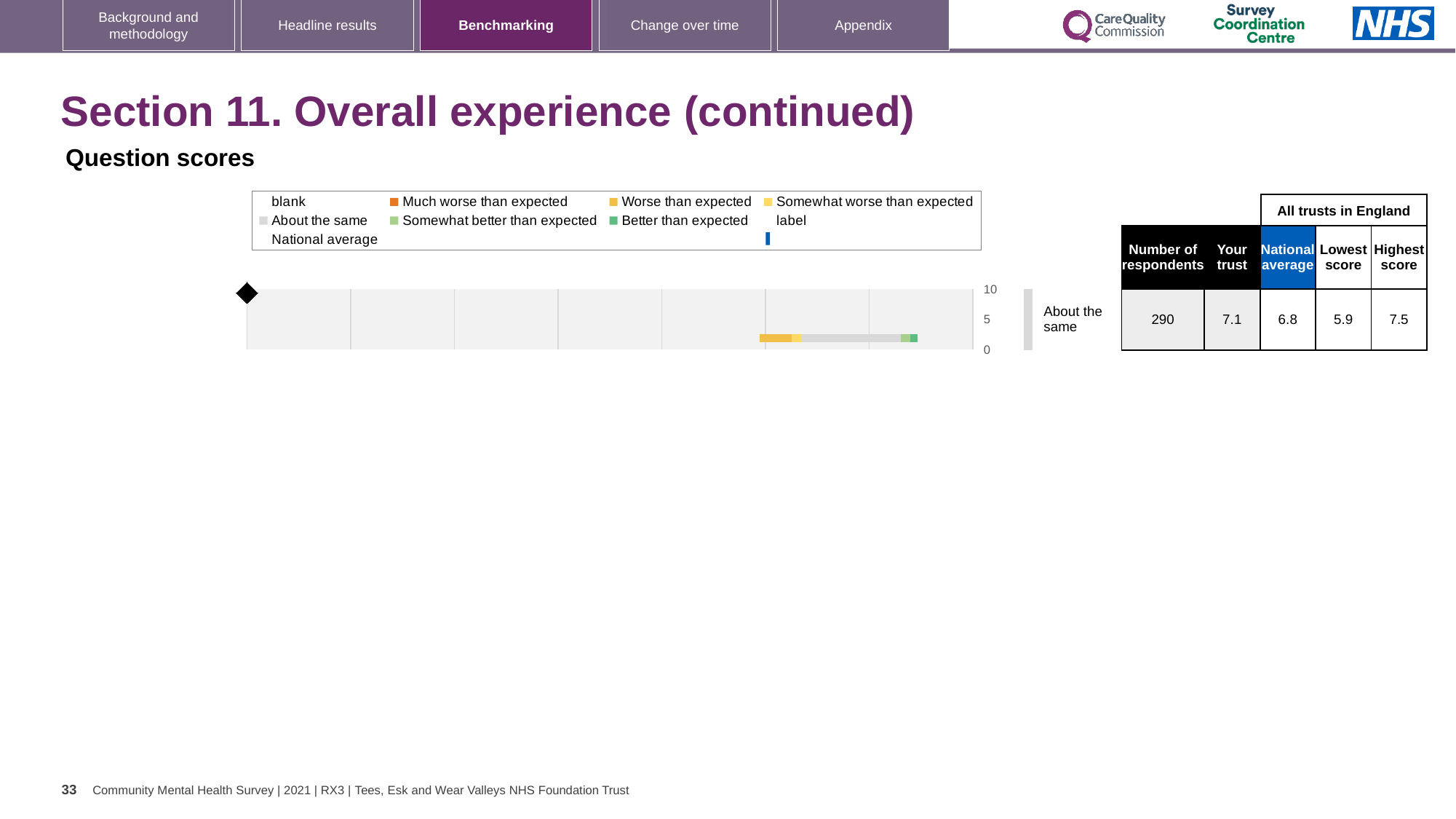
How many question categories are plotted in the chart? 1 What is the National average score for the 'About the same' category? 6.8 What is the label of the single category shown next to the chart? About the same What is the difference between the Highest score and the Lowest score for the 'About the same' category? 1.6 What is the Lowest score among all trusts in England for the 'About the same' category? 5.9 What is the difference between the 'Your trust' score and the National average for the 'About the same' category? 0.3 What is the 'Your trust' score for the 'About the same' category? 7.1 How many respondents are recorded for the 'About the same' category? 290 What is the Highest score among all trusts in England for the 'About the same' category? 7.5 What is the maximum value shown on the chart's score axis? 10 What kind of chart is shown under 'Question scores'? Bar chart Which is larger for the 'About the same' category: the 'Your trust' score or the National average? Your trust